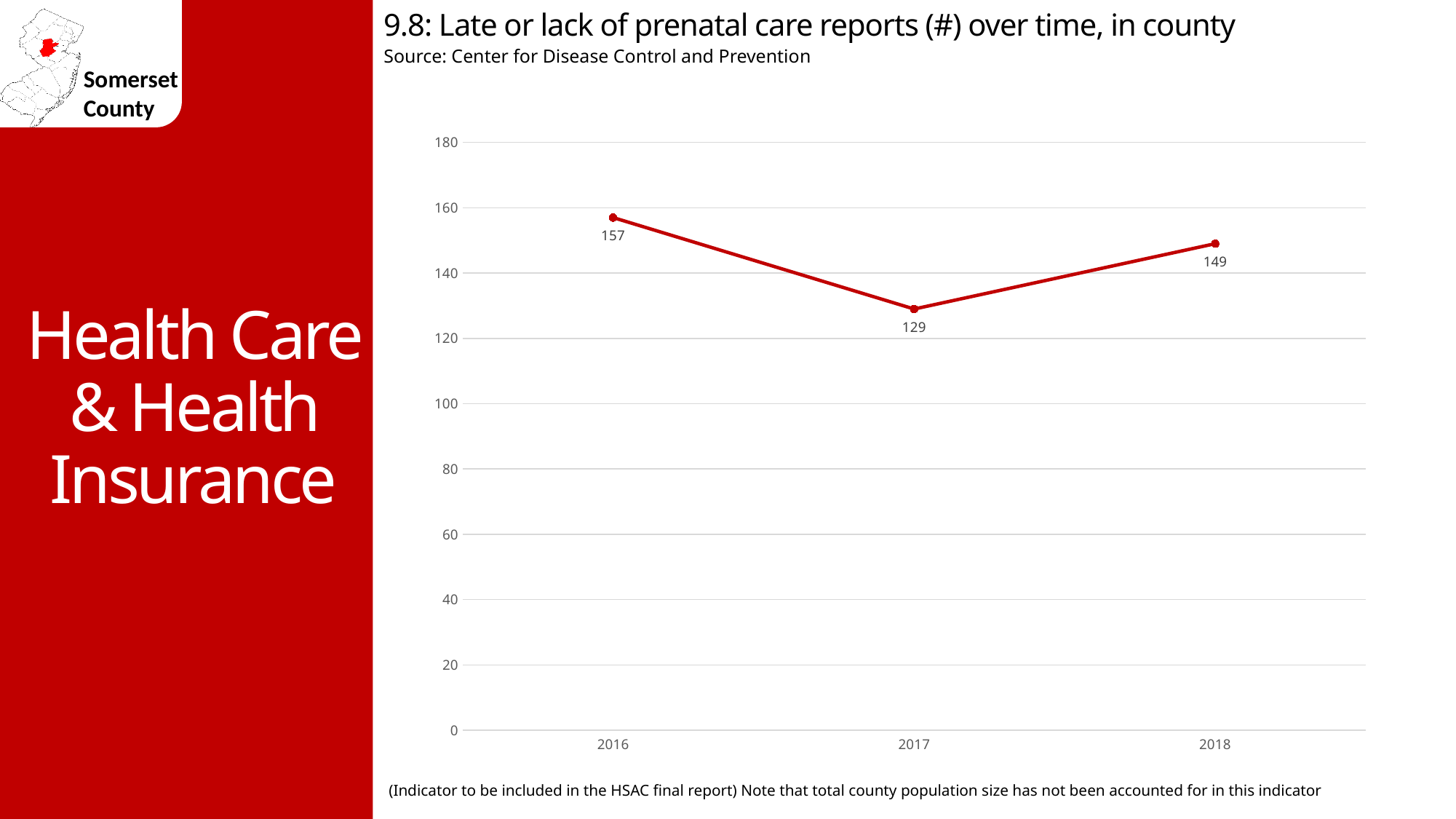
Which year has the highest number of late or lack of prenatal care reports? 2016 What kind of chart is shown on the slide? line chart How many years are plotted on the chart? 3 What is the number of late or lack of prenatal care reports in 2016? 157 Which year has the lowest number of late or lack of prenatal care reports? 2017 What is the number of late or lack of prenatal care reports in 2018? 149 Which year has more late or lack of prenatal care reports, 2016 or 2018? 2016 What is the number of late or lack of prenatal care reports in 2017? 129 Is the value for 2017 greater or less than 140? less What is the difference between the number of reports in 2018 and 2017? 20 What is the difference between the number of reports in 2016 and 2017? 28 What is the source cited for the chart? Center for Disease Control and Prevention